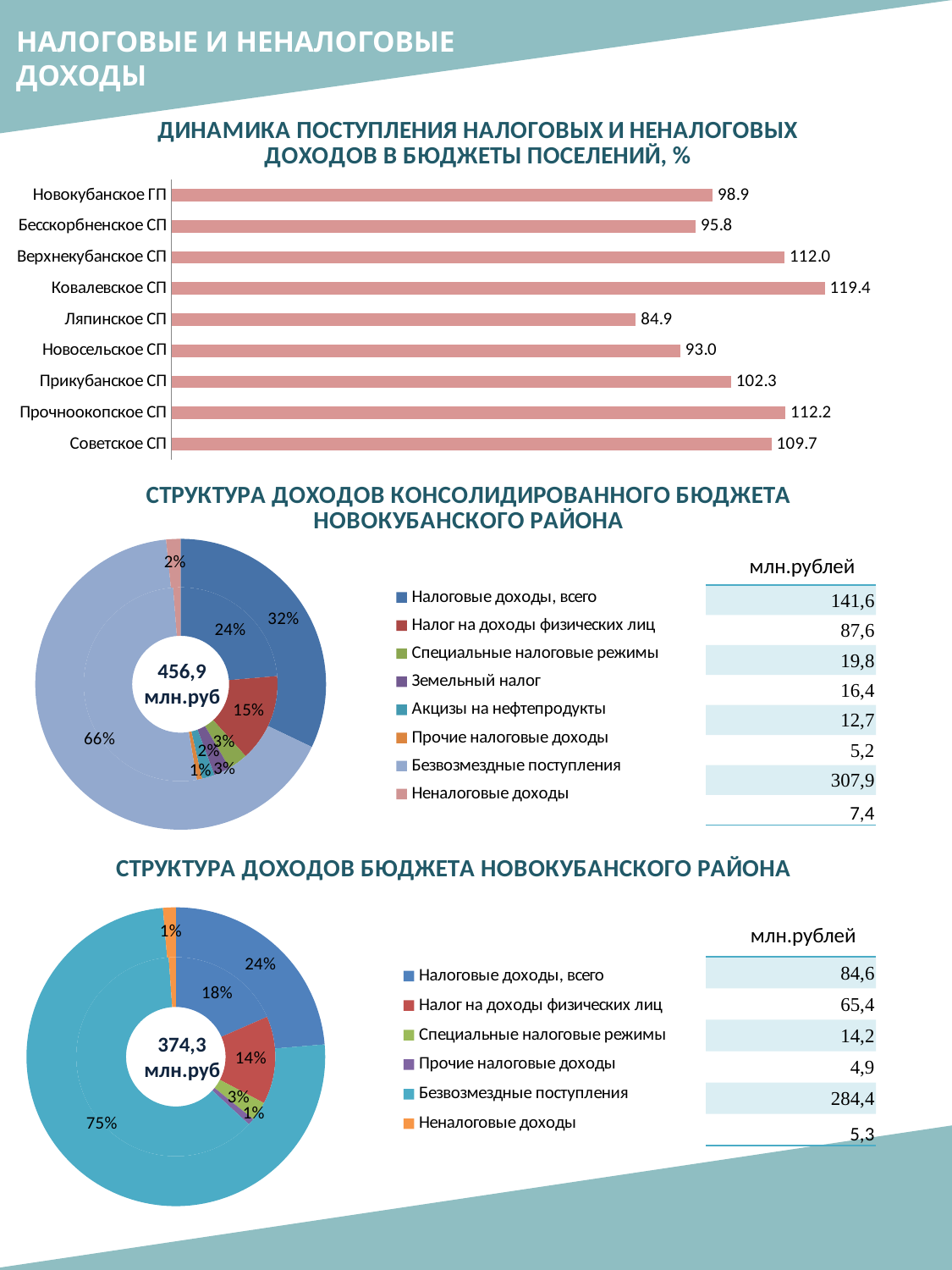
In the bar chart 'Динамика поступления налоговых и неналоговых доходов в бюджеты поселений, %', which settlement has the lowest value? Ляпинское СП In the bar chart 'Динамика поступления налоговых и неналоговых доходов в бюджеты поселений, %', which settlement has the highest value? Ковалевское СП In the chart 'Структура доходов консолидированного бюджета Новокубанского района', what is the value in млн.рублей for Безвозмездные поступления? 307,9 In the bar chart 'Динамика поступления налоговых и неналоговых доходов в бюджеты поселений, %', what is the value for Ковалевское СП? 119.4 How many settlements are shown in the bar chart 'Динамика поступления налоговых и неналоговых доходов в бюджеты поселений, %'? 9 What type of chart is 'Динамика поступления налоговых и неналоговых доходов в бюджеты поселений, %'? Bar chart In the bar chart 'Динамика поступления налоговых и неналоговых доходов в бюджеты поселений, %', what is the difference between Прочноокопское СП and Новосельское СП? 19.2 In the chart 'Структура доходов консолидированного бюджета Новокубанского района', what total amount is shown in the centre of the doughnut? 456,9 млн.руб In the chart 'Структура доходов бюджета Новокубанского района', what is the value in млн.рублей for Налог на доходы физических лиц? 65,4 In the chart 'Структура доходов бюджета Новокубанского района', what share of the doughnut is Безвозмездные поступления? 75% In the bar chart 'Динамика поступления налоговых и неналоговых доходов в бюджеты поселений, %', which is larger: Новокубанское ГП or Бесскорбненское СП? Новокубанское ГП How many entries does the legend of the chart 'Структура доходов консолидированного бюджета Новокубанского района' list? 8